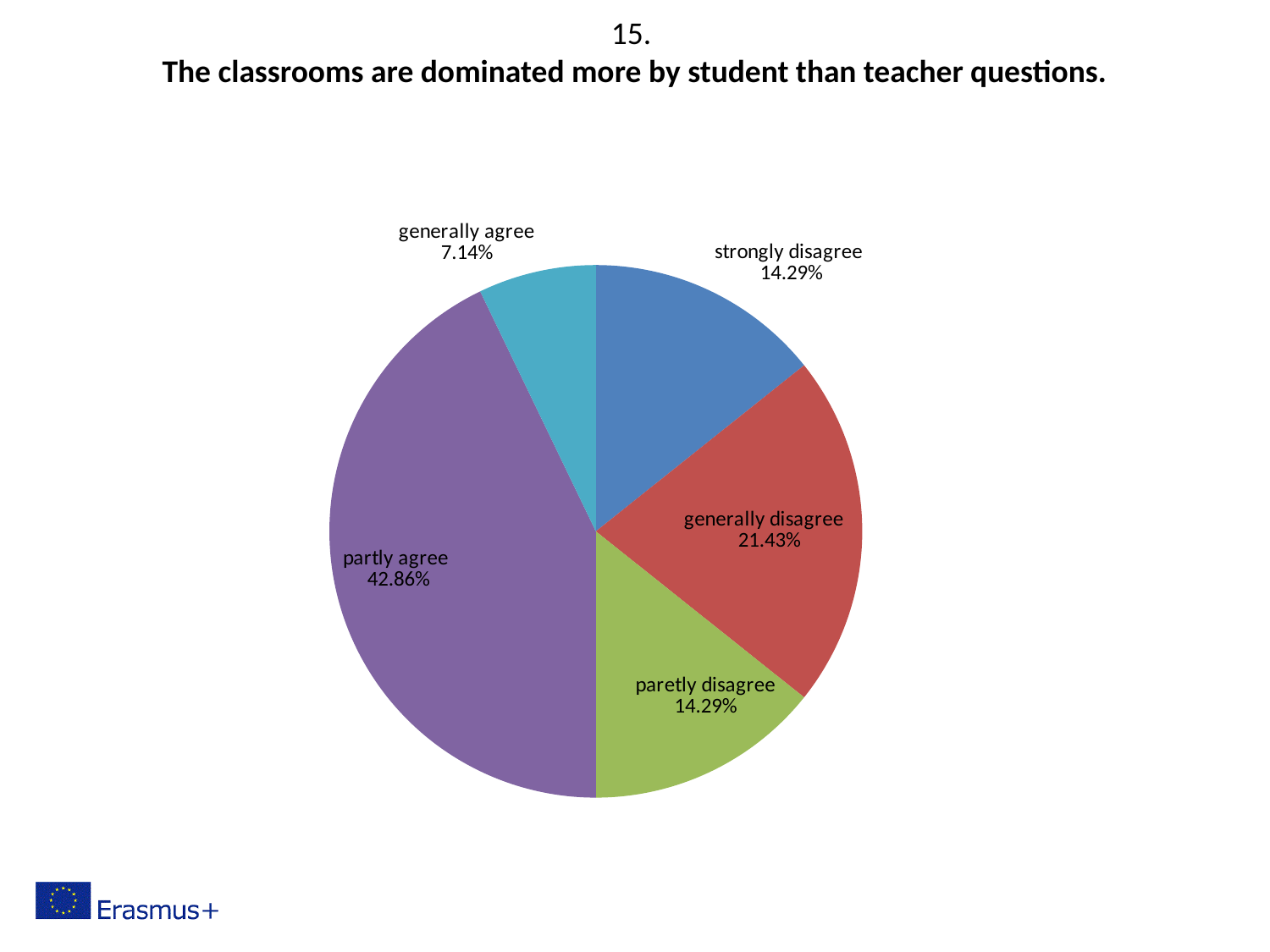
What is the combined share of 'strongly disagree' and 'paretly disagree'? 28.58% Which is larger, the share for 'generally disagree' or the share for 'paretly disagree'? generally disagree What statement is the pie chart about, according to the slide title? The classrooms are dominated more by student than teacher questions. What percentage of respondents chose 'generally agree'? 7.14% How many slices does the pie chart have? 5 What percentage of respondents chose 'generally disagree'? 21.43% Which response category has the largest share of the pie? partly agree Which response category has the smallest share of the pie? generally agree What percentage of respondents chose 'partly agree'? 42.86% What percentage of respondents chose 'strongly disagree'? 14.29% What kind of chart is shown on the slide? pie chart What is the difference in percentage points between 'partly agree' and 'generally disagree'? 21.43